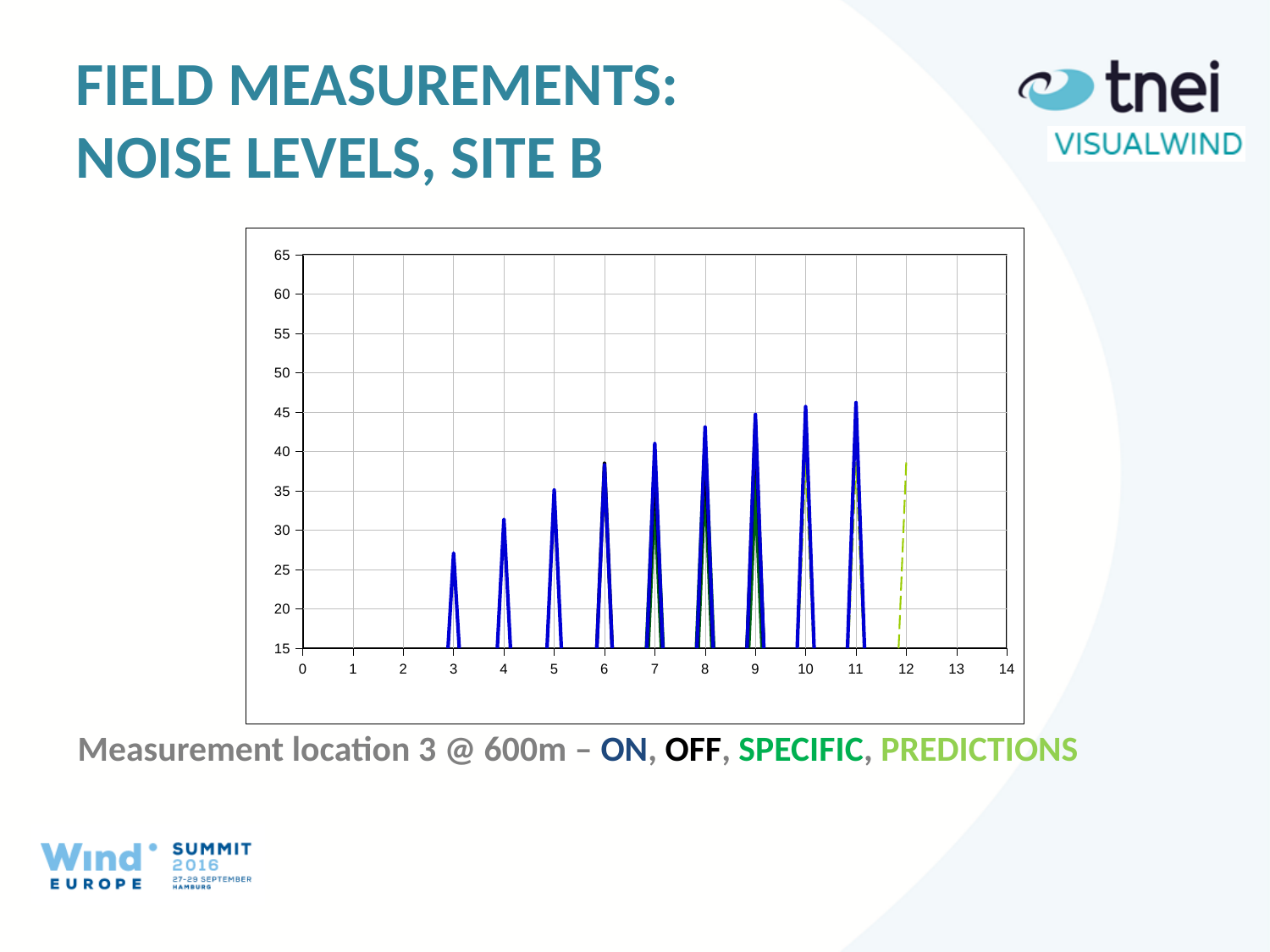
At which x-axis value does the blue line reach its highest peak? 11 According to the caption below the chart, at what distance is measurement location 3? 600m At which x-axis value does the blue line reach its lowest peak? 3 Do the peaks of the blue line rise or fall as the x-axis value increases from 3 to 11? rise What kind of chart is shown on the slide? line chart What is the highest value shown on the y-axis? 65 Is the peak of the blue line at x = 3 greater or less than 25? greater Is the peak of the blue line at x = 6 greater or less than 40? less Is the peak of the blue line at x = 8 greater or less than 45? less Which peak of the blue line is higher, the one at x = 4 or the one at x = 7? x = 7 How many peaks does the blue line have? 9